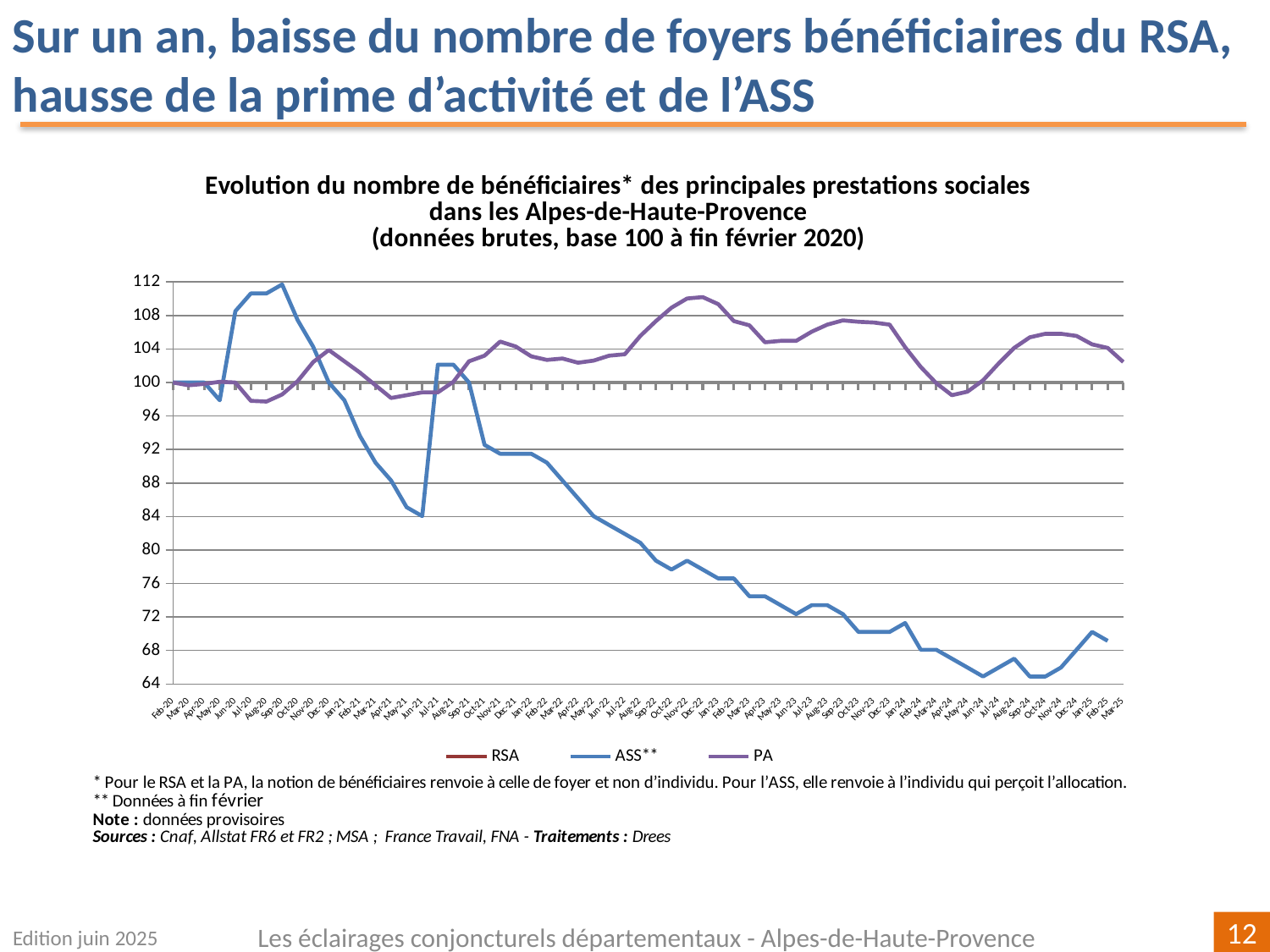
Is the value for PA in Dec-22 greater or less than 108? greater In which month does the ASS** series reach its highest value? Sep-20 What kind of chart is shown on the slide? line chart Is the value for PA in Mar-25 greater or less than 100? greater What is the base value of the index at end of February 2020, according to the chart title? 100 How many series does the legend list? 3 Does the ASS** series generally rise or fall between Sep-21 and Jun-24? fall Which series are listed in the legend? RSA, ASS**, PA Is the value for ASS** in Jun-21 greater or less than 88? less